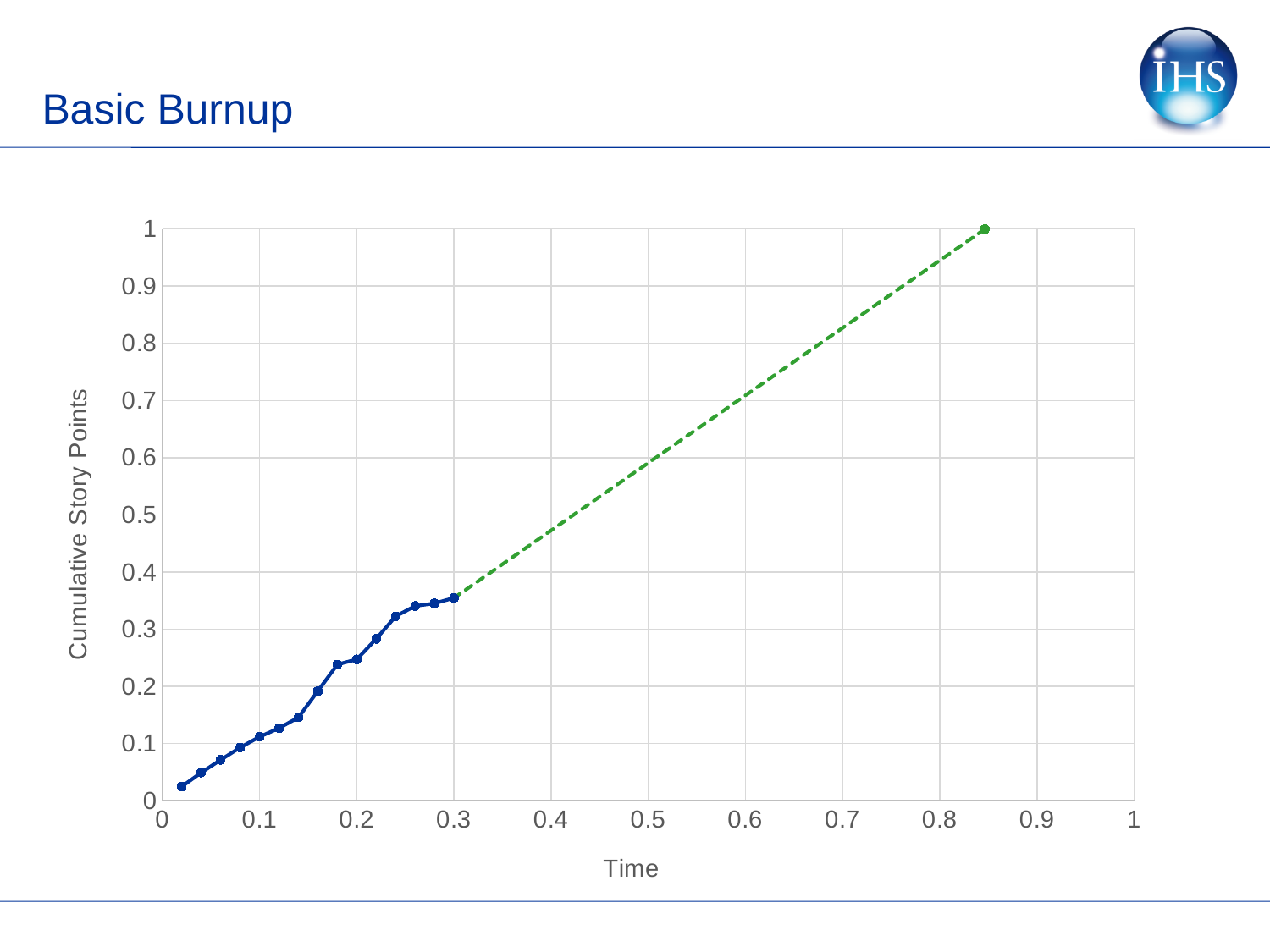
What is the Cumulative Story Points value at the end point of the green dashed line? 1 Do the values of the blue line rise or fall as time increases? rise What kind of chart is shown on the slide? line chart Is the value of the green dashed line at Time 0.5 greater or less than 0.5? greater At which Time value does the solid blue line reach its highest point? 0.3 Is the value of the blue line at Time 0.3 greater or less than 0.4? less Is the value of the blue line at Time 0.2 greater or less than 0.2? greater What is the title of the x axis? Time What is the title of the y axis? Cumulative Story Points How many data points are marked on the solid blue line? 15